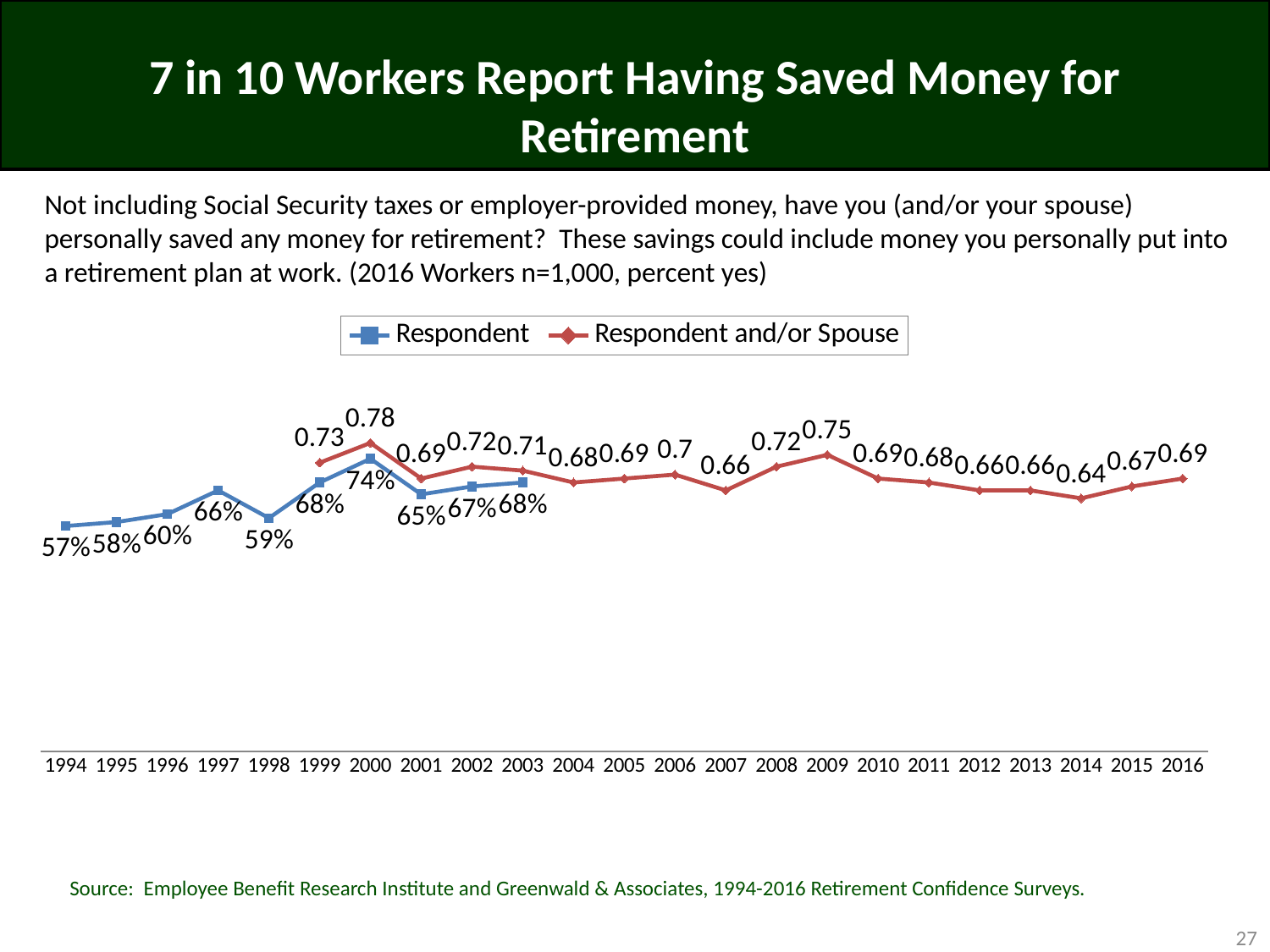
How many years are shown on the x axis? 23 What is the difference between the Respondent and/or Spouse values for 2009 and 2014? 0.11 What is the value for Respondent and/or Spouse in 2007? 0.66 In which year is the Respondent and/or Spouse series at its lowest value? 2014 Does the Respondent and/or Spouse series rise or fall from 2009 to 2014? Fall What is the value for Respondent and/or Spouse in 2016? 0.69 What kind of chart is shown on the slide? Line chart How many series does the legend list? 2 What is the value for Respondent in 1994? 57% In which year does the Respondent and/or Spouse series reach its highest value? 2000 In 2000, which series has the higher value, Respondent or Respondent and/or Spouse? Respondent and/or Spouse In which year is the Respondent series at its lowest value? 1994